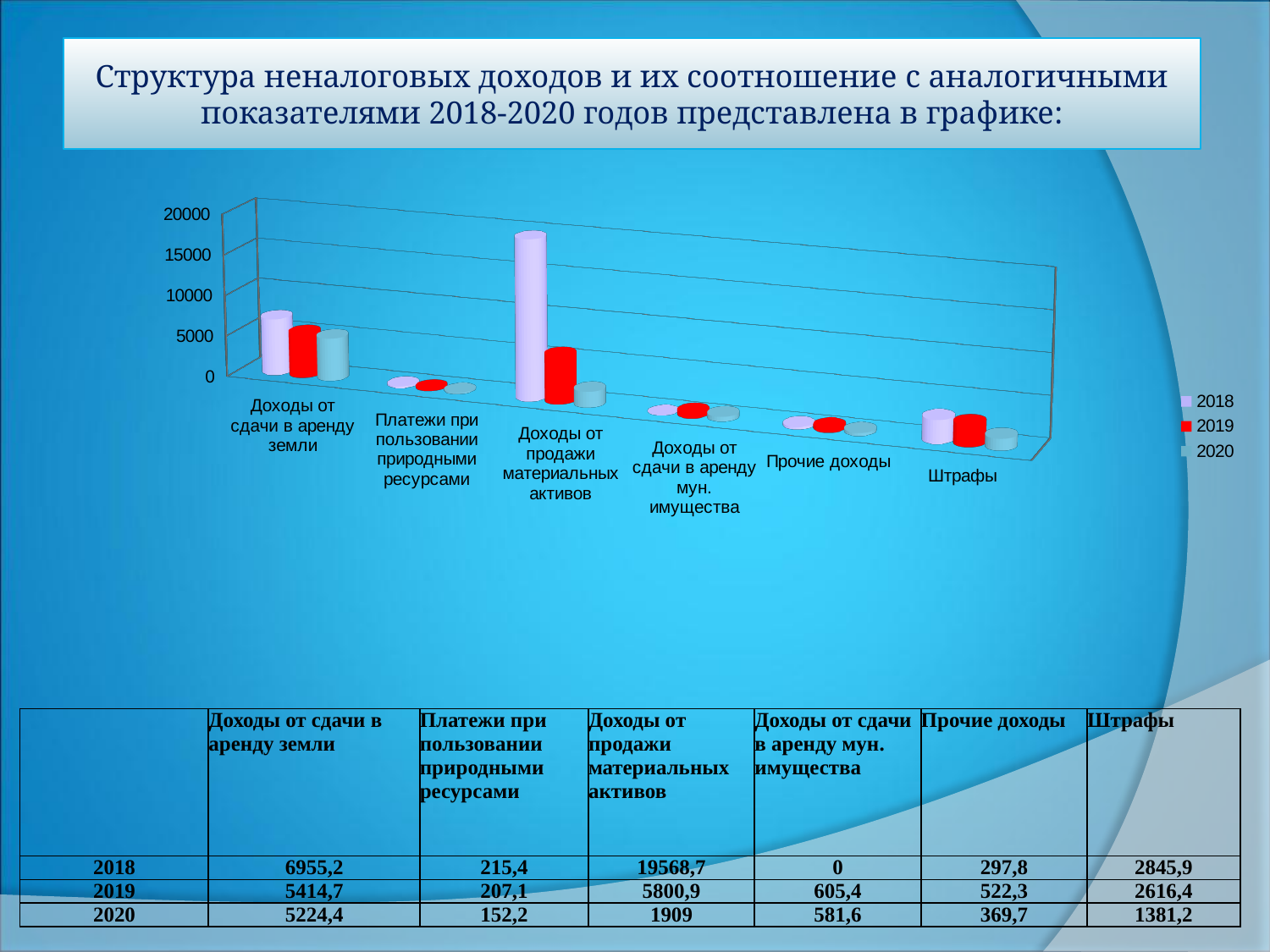
Is the 2018 value for Доходы от продажи материальных активов greater or less than 15000? greater How many series does the chart legend list? 3 Which category has the tallest bar in the chart? Доходы от продажи материальных активов What is the value for Доходы от продажи материальных активов in 2018? 19568,7 What is the value for Доходы от сдачи в аренду мун. имущества in 2018? 0 Do the values for Штрафы rise or fall from 2018 to 2020? fall How many categories are shown along the x axis of the chart? 6 What kind of chart is shown on the slide? bar chart Which is larger in 2019: Штрафы or Прочие доходы? Штрафы What is the difference between the 2018 and 2019 values for Доходы от сдачи в аренду земли? 1540,5 What colour represents the 2019 series in the chart legend? red What is the value for Штрафы in 2020? 1381,2